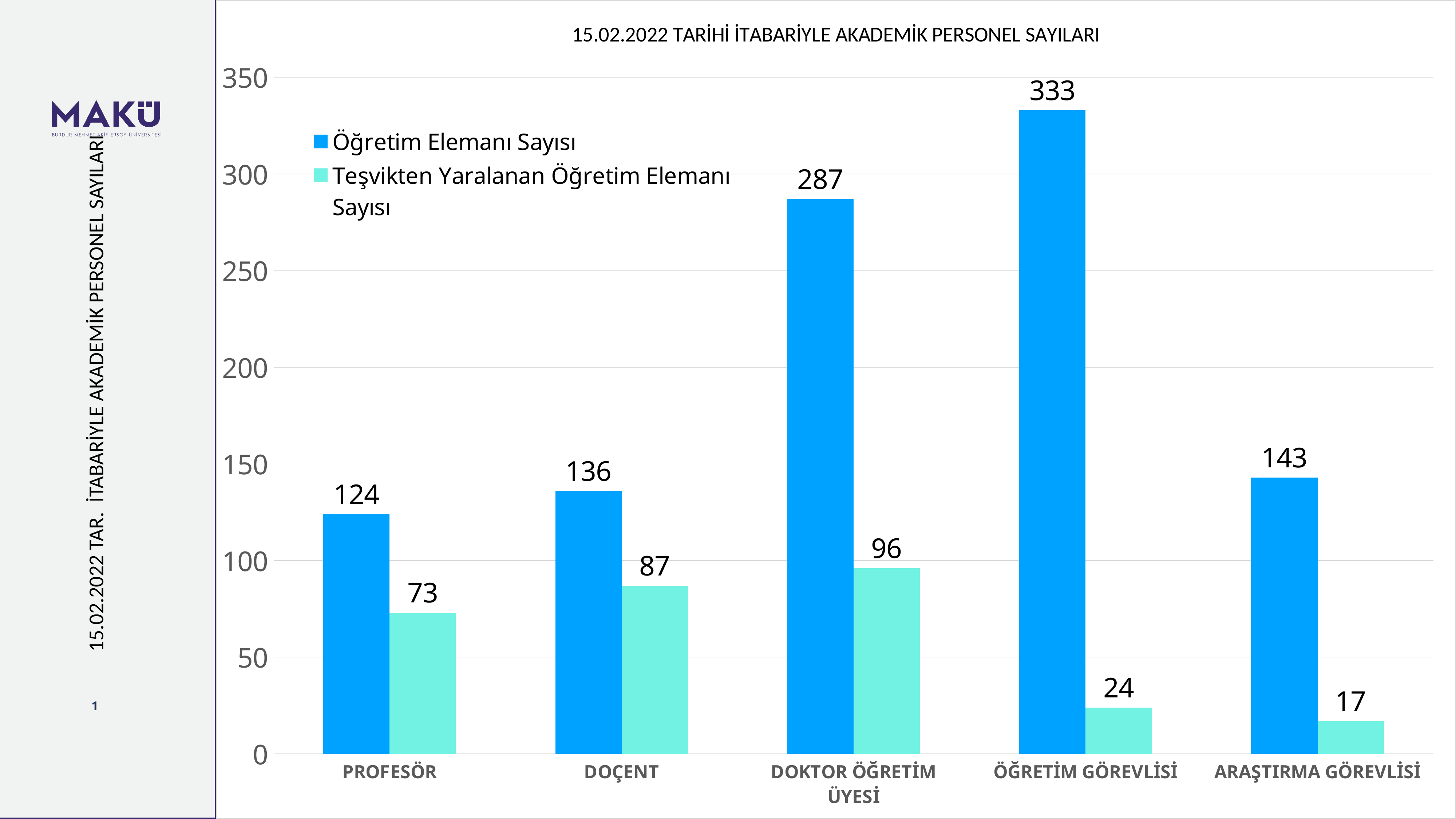
What is the Öğretim Elemanı Sayısı value for DOÇENT? 136 What is the Teşvikten Yaralanan Öğretim Elemanı Sayısı value for PROFESÖR? 73 How many series does the legend list? 2 Is the Öğretim Elemanı Sayısı for DOKTOR ÖĞRETİM ÜYESİ greater or less than 250? greater Which is larger: the Öğretim Elemanı Sayısı for PROFESÖR or for ARAŞTIRMA GÖREVLİSİ? ARAŞTIRMA GÖREVLİSİ What is the difference between the Öğretim Elemanı Sayısı and the Teşvikten Yaralanan Öğretim Elemanı Sayısı for DOKTOR ÖĞRETİM ÜYESİ? 191 What is the Teşvikten Yaralanan Öğretim Elemanı Sayısı value for ARAŞTIRMA GÖREVLİSİ? 17 Which category has the highest Öğretim Elemanı Sayısı? ÖĞRETİM GÖREVLİSİ What kind of chart is shown on the slide? Bar chart Which category has the lowest Teşvikten Yaralanan Öğretim Elemanı Sayısı? ARAŞTIRMA GÖREVLİSİ What is the title of the chart? 15.02.2022 TARİHİ İTABARİYLE AKADEMİK PERSONEL SAYILARI How many categories are shown on the x axis? 5